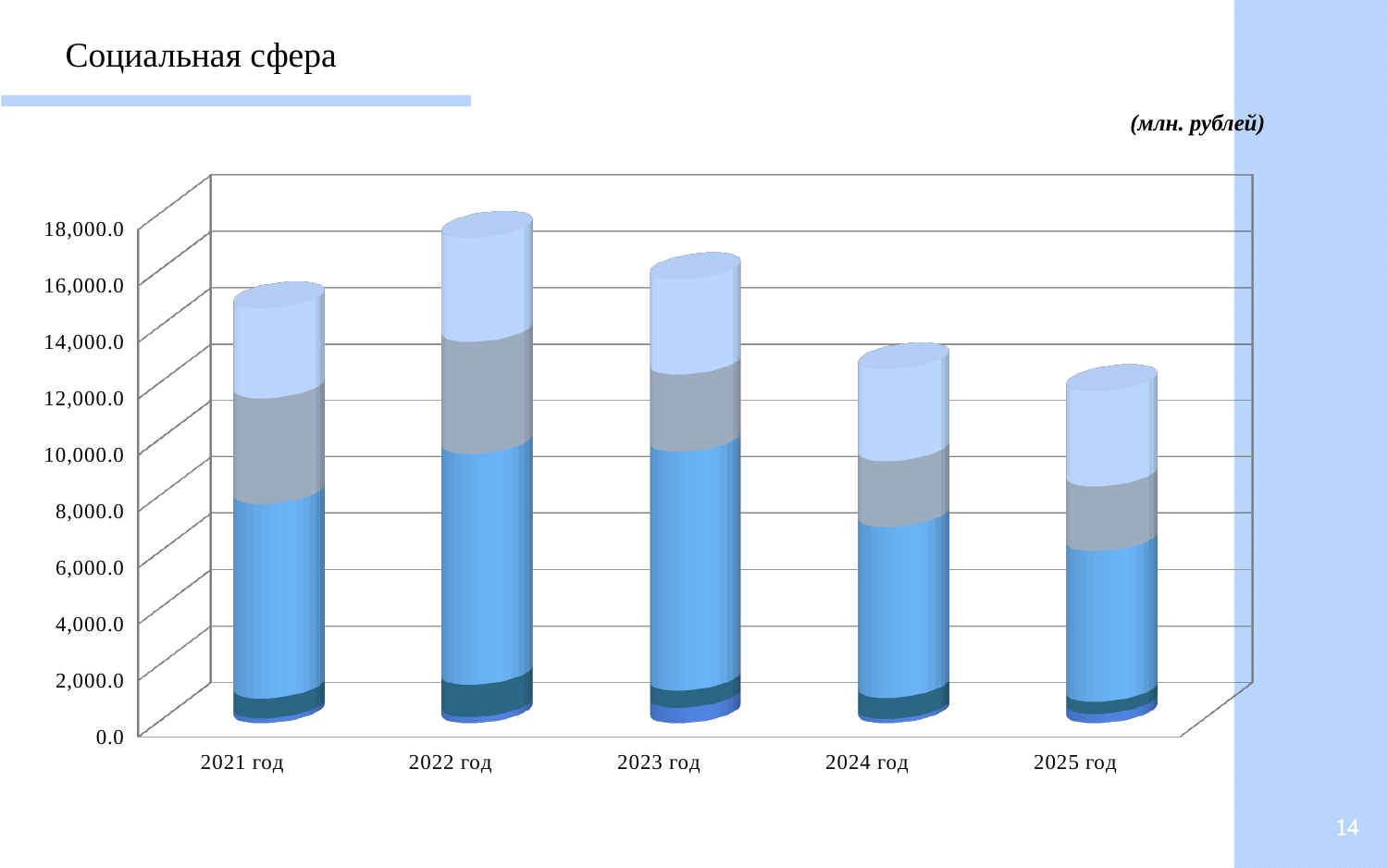
Is the total height of the 2025 год bar greater or less than 10,000.0? greater Which stacked bar is taller, 2021 год or 2024 год? 2021 год Is the total height of the 2024 год bar greater or less than 14,000.0? less From 2022 год to 2025 год, do the total bar heights rise or fall? fall Which year has the tallest stacked bar in the chart? 2022 год What unit of measurement is indicated for the chart values? млн. рублей How many years (categories) are shown on the x axis of the chart? 5 Which stacked bar is taller, 2023 год or 2025 год? 2023 год Which year has the shortest stacked bar in the chart? 2025 год What kind of chart is shown on the slide? stacked bar chart Is the total height of the 2022 год bar greater or less than 16,000.0? greater